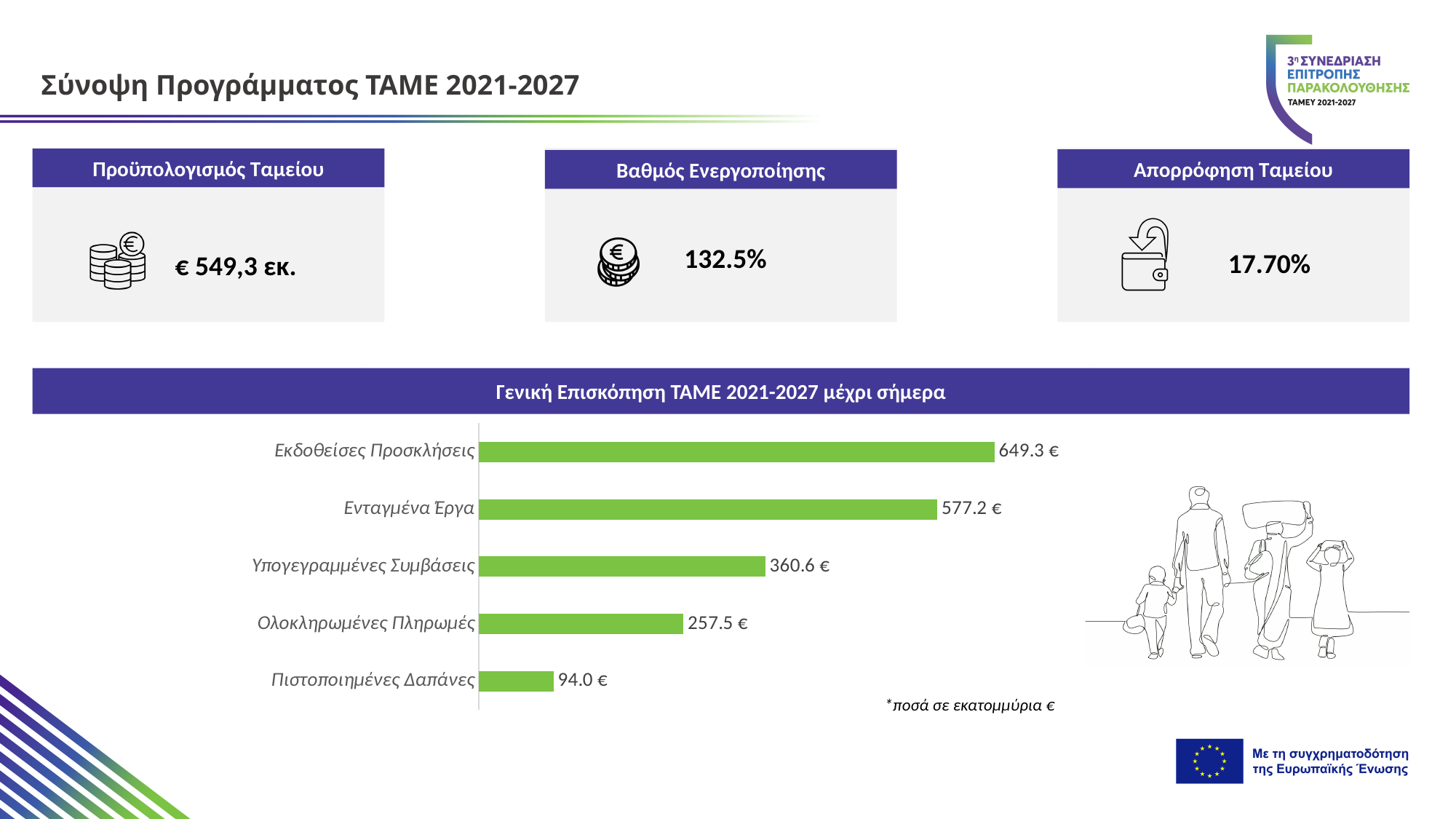
What is the value for Υπογεγραμμένες Συμβάσεις in the chart? 360.6 € What is the value for Ενταγμένα Έργα in the chart? 577.2 € What is the difference between the values for Υπογεγραμμένες Συμβάσεις and Ολοκληρωμένες Πληρωμές? 103.1 € Which category has the lowest value in the chart? Πιστοποιημένες Δαπάνες What type of chart is shown on the slide? Bar chart Which category has the highest value in the chart? Εκδοθείσες Προσκλήσεις What is the value for Εκδοθείσες Προσκλήσεις in the chart? 649.3 € How many categories are shown in the chart? 5 What is the difference between the values for Εκδοθείσες Προσκλήσεις and Ενταγμένα Έργα? 72.1 € What is the value for Ολοκληρωμένες Πληρωμές in the chart? 257.5 € What is the value for Πιστοποιημένες Δαπάνες in the chart? 94.0 € Which is larger, the value for Ολοκληρωμένες Πληρωμές or the value for Πιστοποιημένες Δαπάνες? Ολοκληρωμένες Πληρωμές